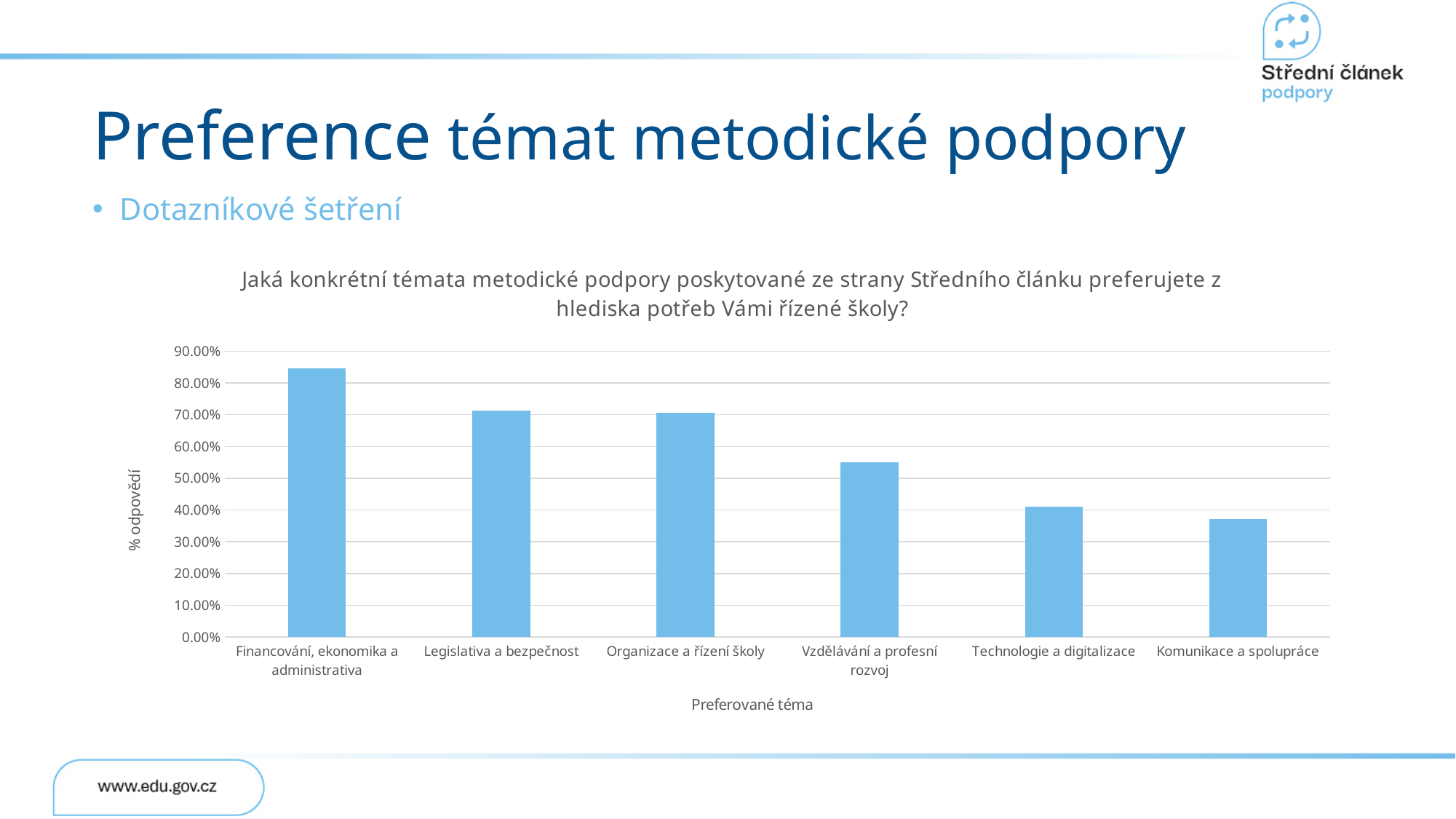
How many categories are shown on the x axis of the chart? 6 Is the value for Komunikace a spolupráce greater or less than 40.00%? less Is the value for Financování, ekonomika a administrativa greater or less than 80.00%? greater Which is larger, the value for Vzdělávání a profesní rozvoj or the value for Technologie a digitalizace? Vzdělávání a profesní rozvoj What kind of chart is shown on the slide? Bar chart What is the label of the y axis of the chart? % odpovědí Which category has the highest value in the chart? Financování, ekonomika a administrativa Which category has the lowest value in the chart? Komunikace a spolupráce Is the value for Vzdělávání a profesní rozvoj greater or less than 60.00%? less Do the values rise or fall from left to right along the x axis? Fall